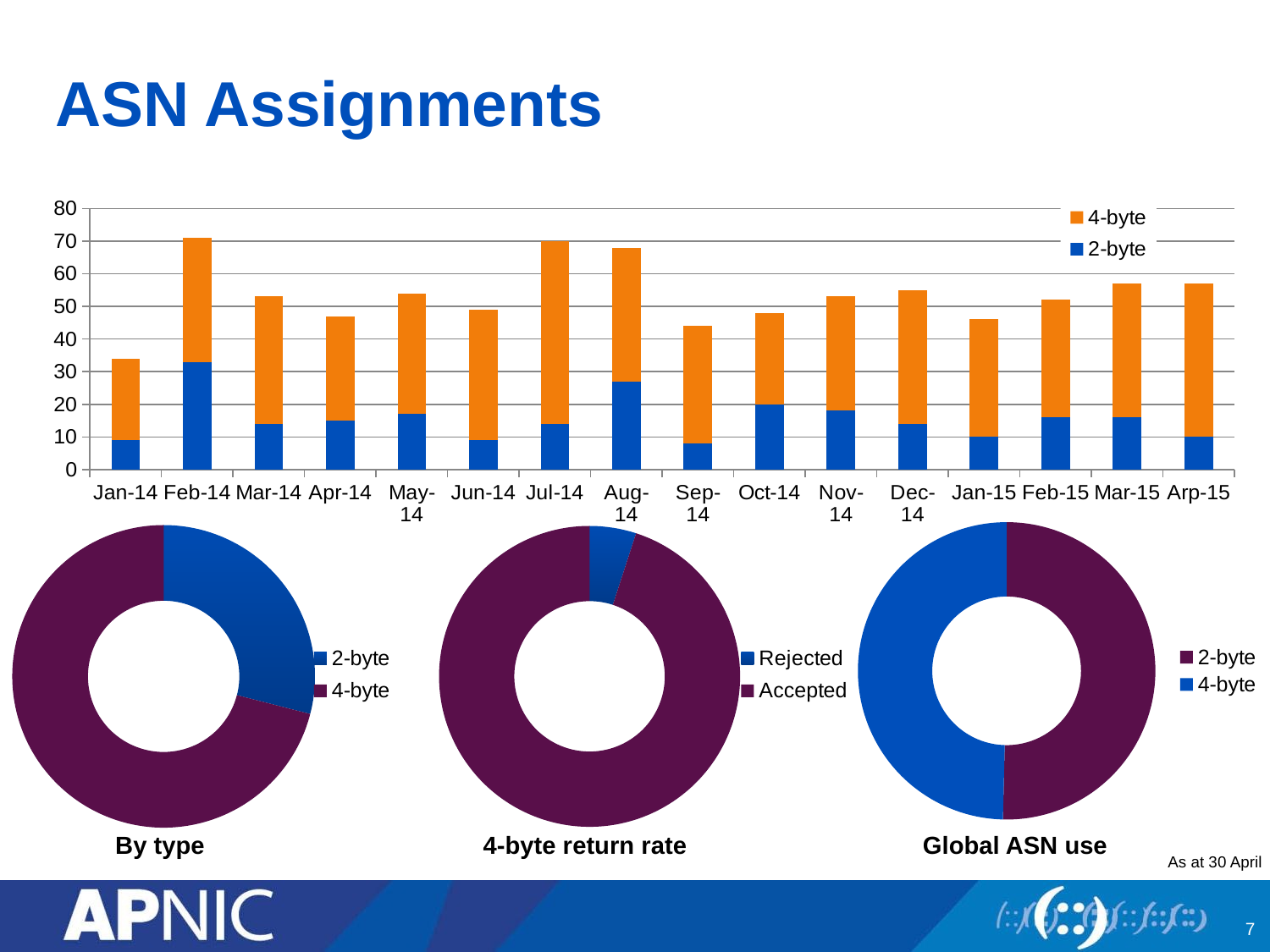
In the top bar chart, which month has the largest 2-byte segment? Feb-14 In the '4-byte return rate' donut chart, which is larger, Rejected or Accepted? Accepted In the top bar chart, which month has the lowest total bar? Jan-14 In the top bar chart, is the total for Feb-14 greater or less than 60? greater How many series does the legend of the top bar chart list? 2 In the top bar chart, is the total for Sep-14 greater or less than 50? less In the top bar chart, is the total for Jan-14 greater or less than 40? less In the 'By type' donut chart, which is larger, 2-byte or 4-byte? 4-byte What kind of chart is the top chart on the slide? stacked bar chart How many months are shown on the x axis of the top bar chart? 16 What are the two legend entries of the '4-byte return rate' donut chart? Rejected, Accepted